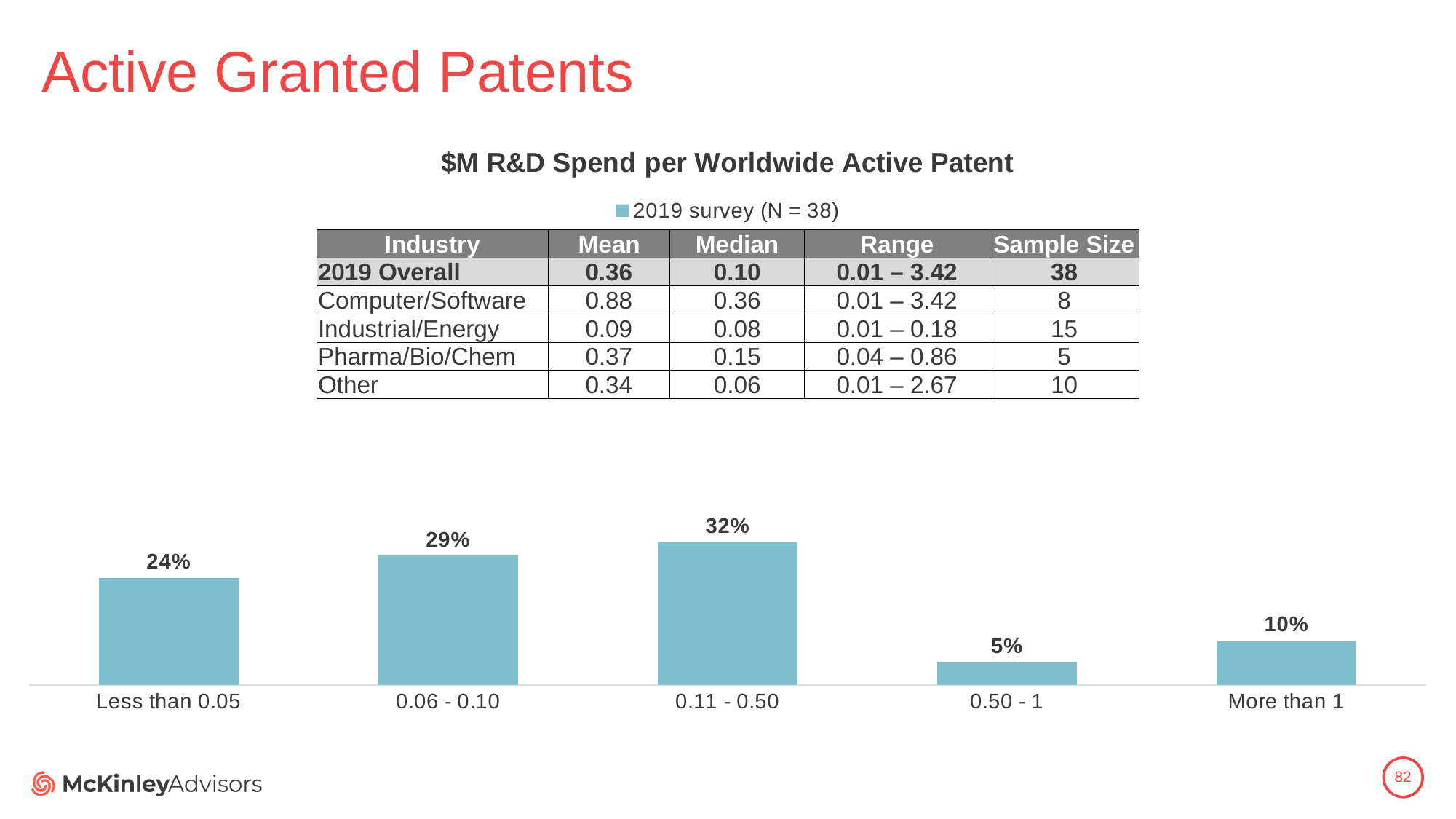
What percentage is shown for the '0.11 - 0.50' category? 32% How many series does the legend list? 1 What percentage is shown for the 'More than 1' category? 10% What is the title of the chart? $M R&D Spend per Worldwide Active Patent What percentage is shown for the 'Less than 0.05' category? 24% What is the difference in percentage points between the '0.06 - 0.10' and '0.50 - 1' categories? 24 What is the legend entry for the series in the chart? 2019 survey (N = 38) Which is larger, the value for 'Less than 0.05' or the value for 'More than 1'? Less than 0.05 Which category has the highest percentage? 0.11 - 0.50 Which category has the lowest percentage? 0.50 - 1 How many categories are shown on the x axis of the chart? 5 What kind of chart is shown on the slide? Bar chart